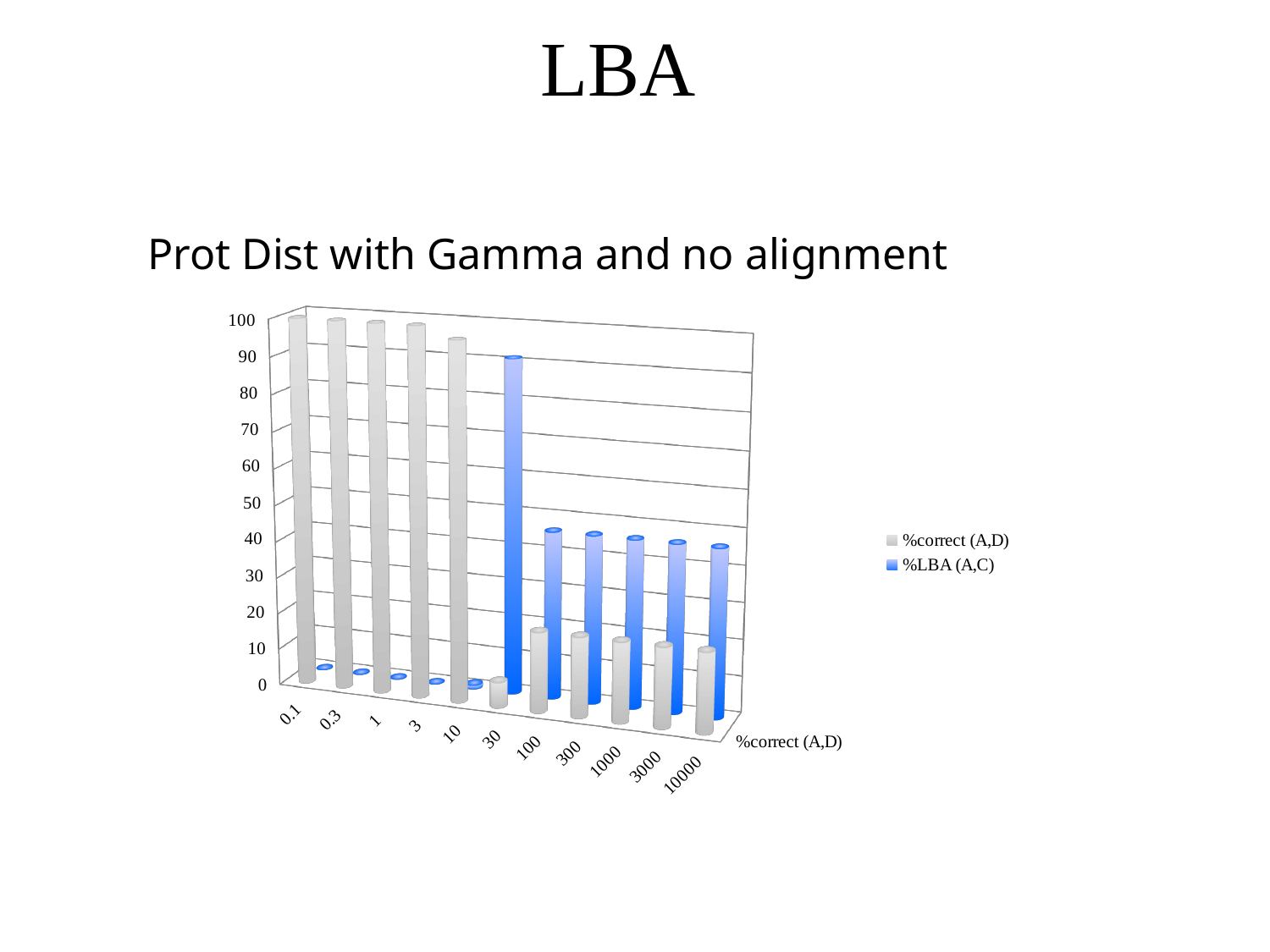
How many series does the legend list? 2 For which category is %correct (A,D) lowest? 30 Is the value of %LBA (A,C) at 100 greater or less than 70? less Which series is shown in blue? %LBA (A,C) For which category is %LBA (A,C) highest? 30 Is the value of %correct (A,D) at 0.1 greater or less than 90? greater How many categories are shown on the x axis? 11 At category 100, which series has the larger value, %correct (A,D) or %LBA (A,C)? %LBA (A,C) What is the title of the chart? Prot Dist with Gamma and no alignment Is the value of %LBA (A,C) at 0.1 greater or less than 10? less What kind of chart is shown on the slide? bar chart